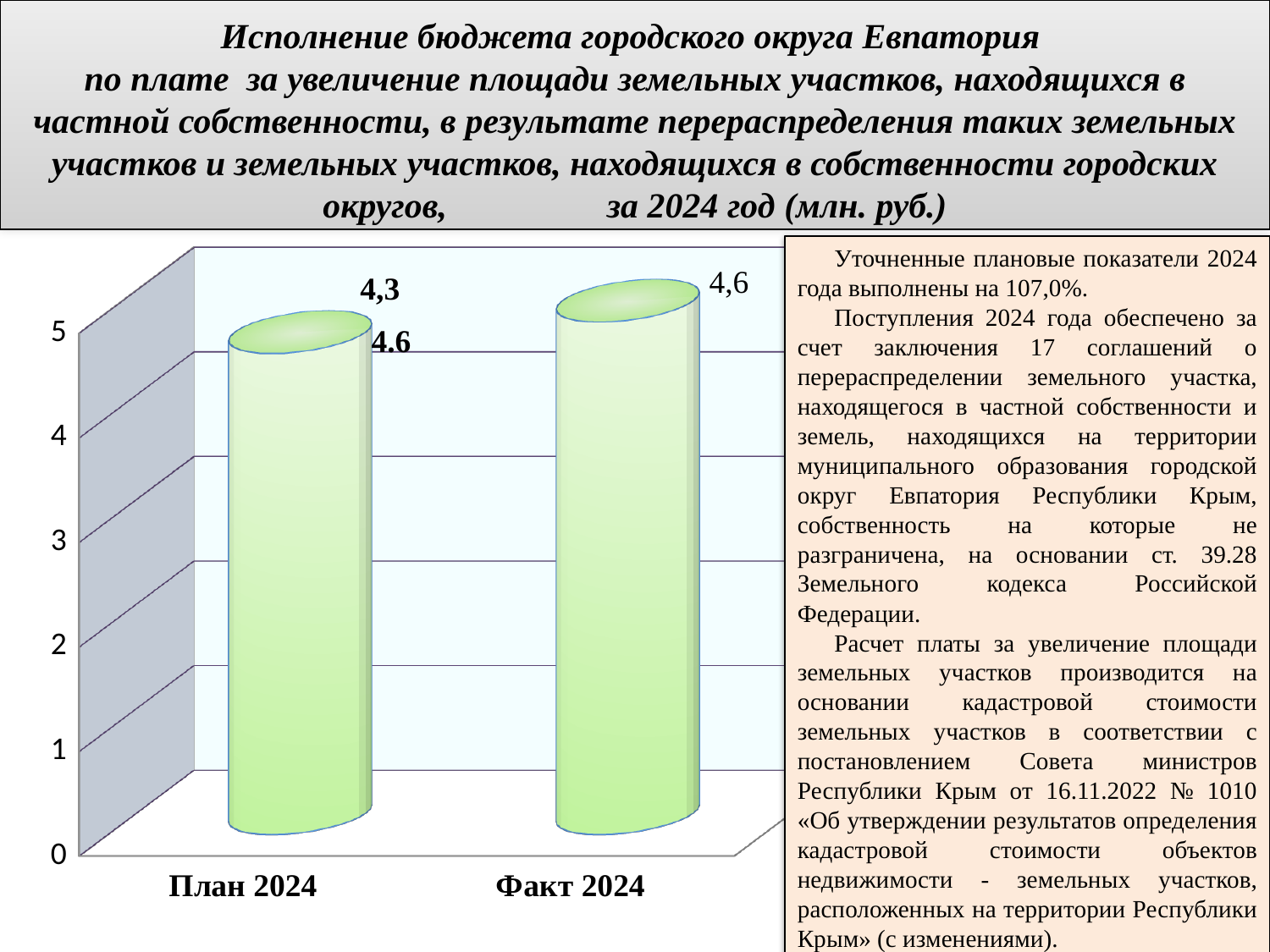
Which category has the lowest value? План 2024 Is the value for План 2024 greater or less than 3? greater Which category has the highest value? Факт 2024 What is the value for Факт 2024? 4,6 How many categories are shown on the x axis? 2 Do the values rise or fall from План 2024 to Факт 2024? rise Is the value for План 2024 greater or less than 4? greater Is the value for Факт 2024 greater or less than 5? less What kind of chart is shown on the slide? bar chart In what units are the values given according to the chart title? млн. руб. What is the highest tick value shown on the vertical axis? 5 Which category has the higher value, План 2024 or Факт 2024? Факт 2024